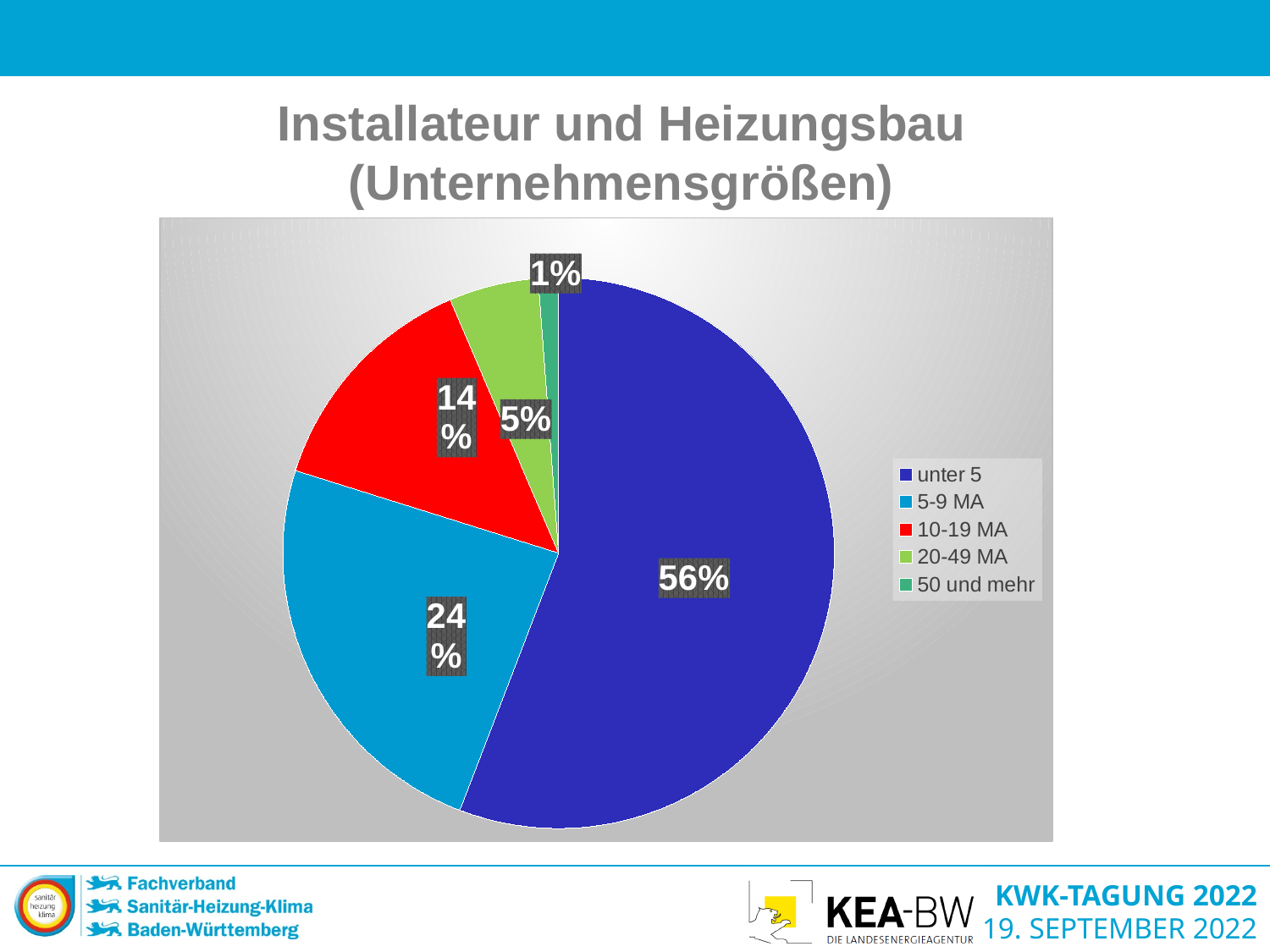
What is the title of the chart? Installateur und Heizungsbau (Unternehmensgrößen) What is the share for the 'unter 5' category? 56% Which category has the smallest share of the pie? 50 und mehr Which category has the largest share of the pie? unter 5 Which has a larger share, '10-19 MA' or '20-49 MA'? 10-19 MA What is the share for the '20-49 MA' category? 5% How many categories does the legend list? 5 What is the share for the '10-19 MA' category? 14% What is the difference in percentage points between the 'unter 5' and '5-9 MA' shares? 32 What is the share for the '50 und mehr' category? 1% What is the share for the '5-9 MA' category? 24% What type of chart is shown on the slide? pie chart